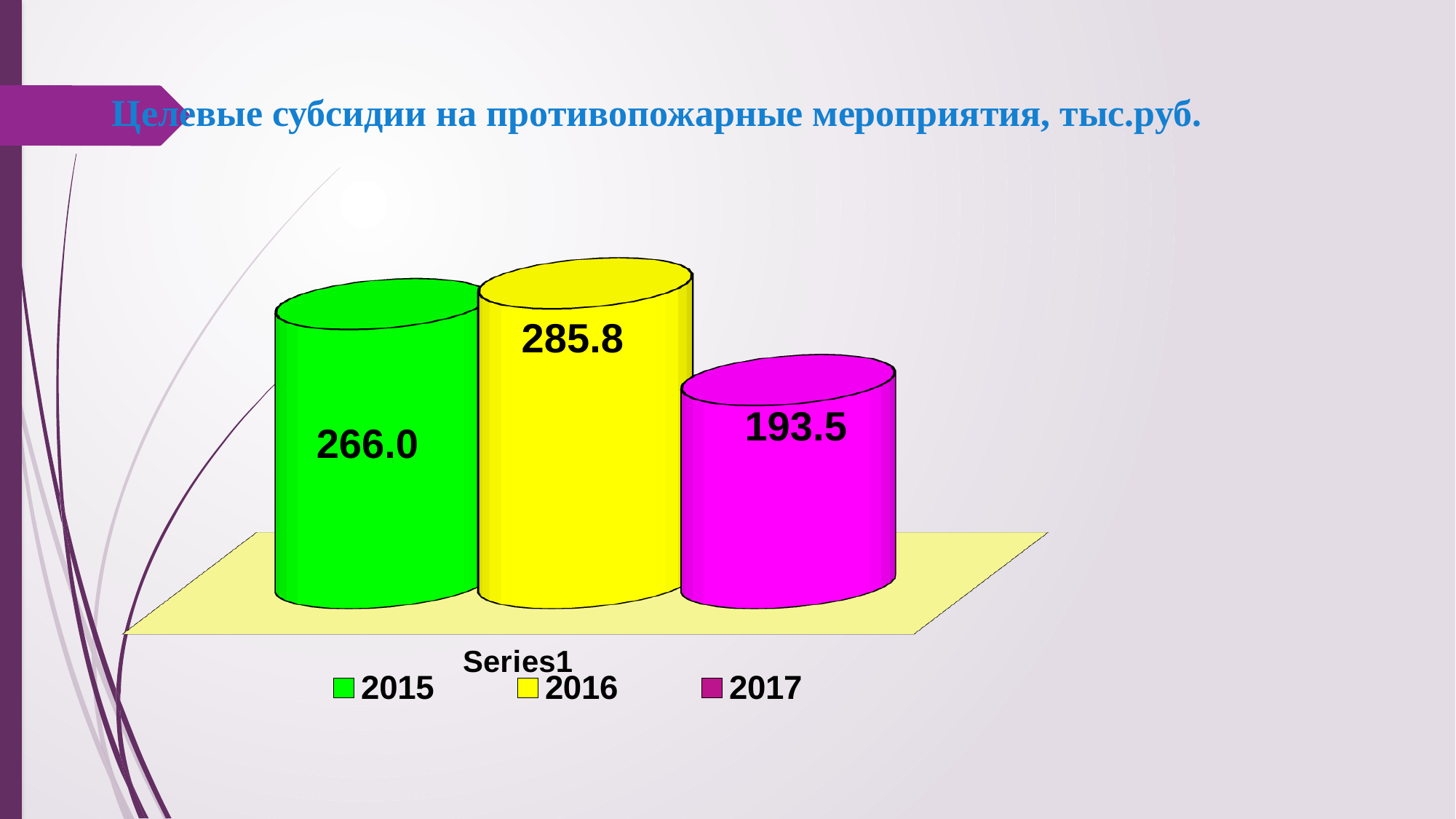
Which year has the lowest value? 2017 What is the value for 2017? 193.5 What colour is the bar for 2017? magenta Which is larger, the value for 2015 or the value for 2017? 2015 What is the difference between the values for 2015 and 2017? 72.5 Which year has the highest value? 2016 What kind of chart is shown on the slide? bar chart What is the difference between the values for 2016 and 2015? 19.8 What is the value for 2016? 285.8 How many bars are plotted in the chart? 3 What is the value for 2015? 266.0 How many entries does the legend list? 3